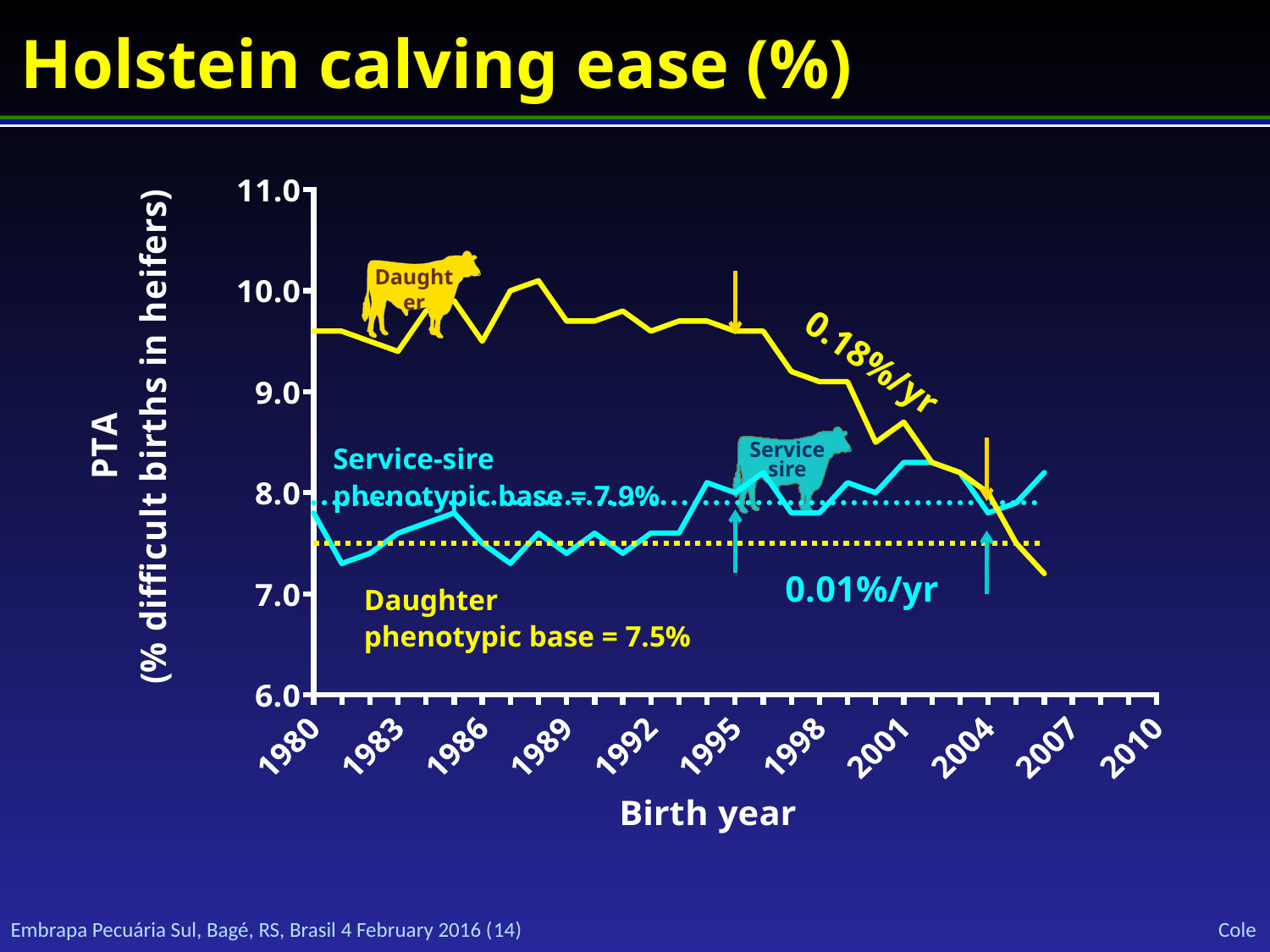
Is the Daughter value for birth year 1980 greater or less than 9.0? greater Is the Service sire value for birth year 1982 greater or less than 8.0? less What kind of chart is shown on the slide? line chart Does the Daughter (yellow) line generally rise or fall from 1980 to 2007? fall What is the Service-sire phenotypic base shown on the chart? 7.9% What is the label of the x axis? Birth year How many data series are plotted on the chart? 4 For birth year 1990, which series has the higher value, Daughter or Service sire? Daughter What is the title of the slide's chart? Holstein calving ease (%) What annual rate of change is annotated for the Service sire (cyan) line? 0.01%/yr What is the Daughter phenotypic base shown on the chart? 7.5% What annual rate of change is annotated for the Daughter (yellow) line? 0.18%/yr